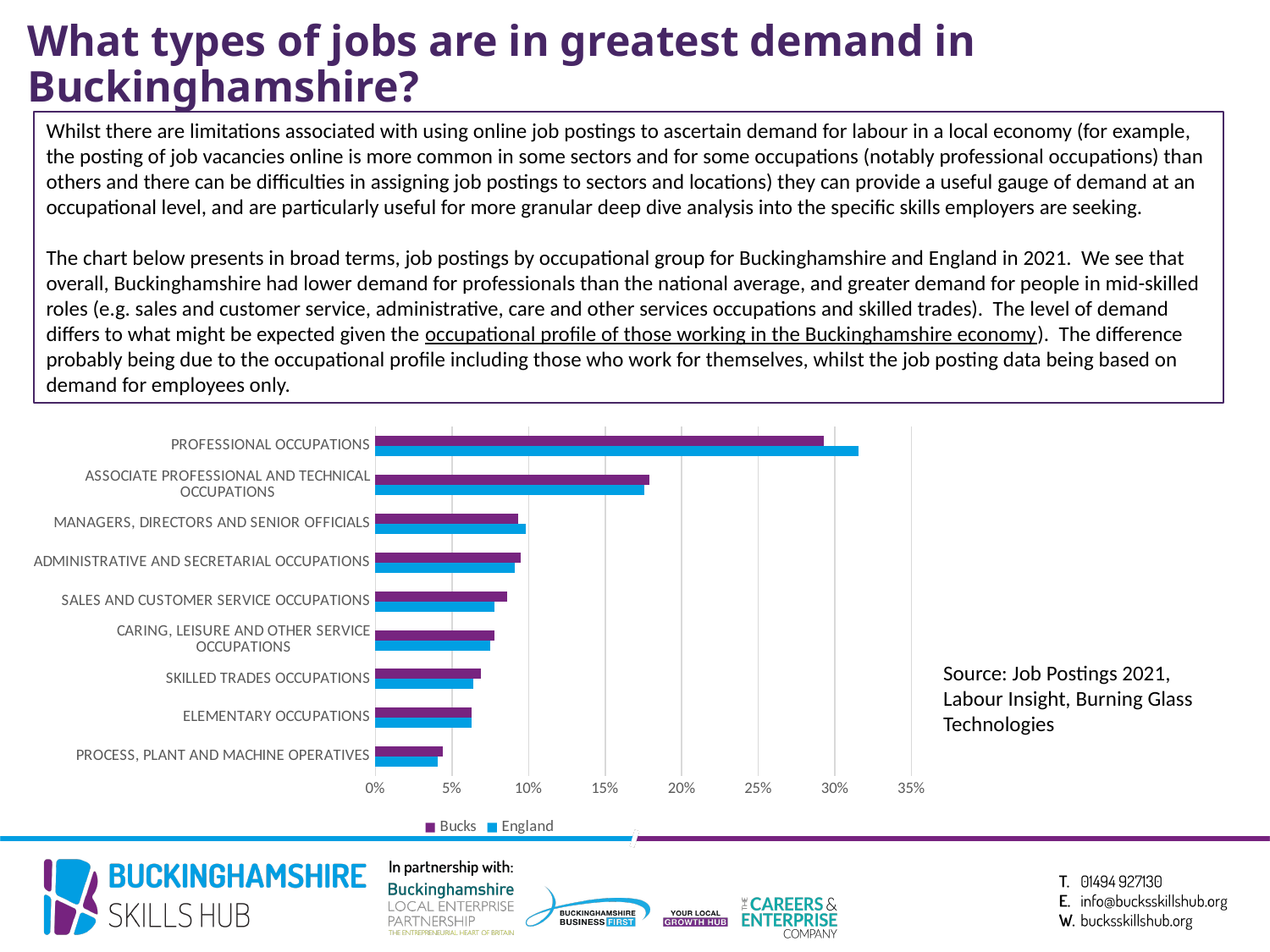
Which series is shown in purple on the chart? Bucks Is the England value for professional occupations greater or less than 30%? greater How many series does the chart's legend list? 2 How many occupational groups are plotted on the chart? 9 Is the Bucks value for associate professional and technical occupations greater or less than 15%? greater Is the England value for elementary occupations greater or less than 10%? less Which occupational group has the lowest share of job postings for England? Process, plant and machine operatives For professional occupations, which is larger: the Bucks value or the England value? England What kind of chart is shown on the slide? bar chart What are the two series named in the chart's legend? Bucks and England Which occupational group has the highest share of job postings for Bucks? Professional occupations